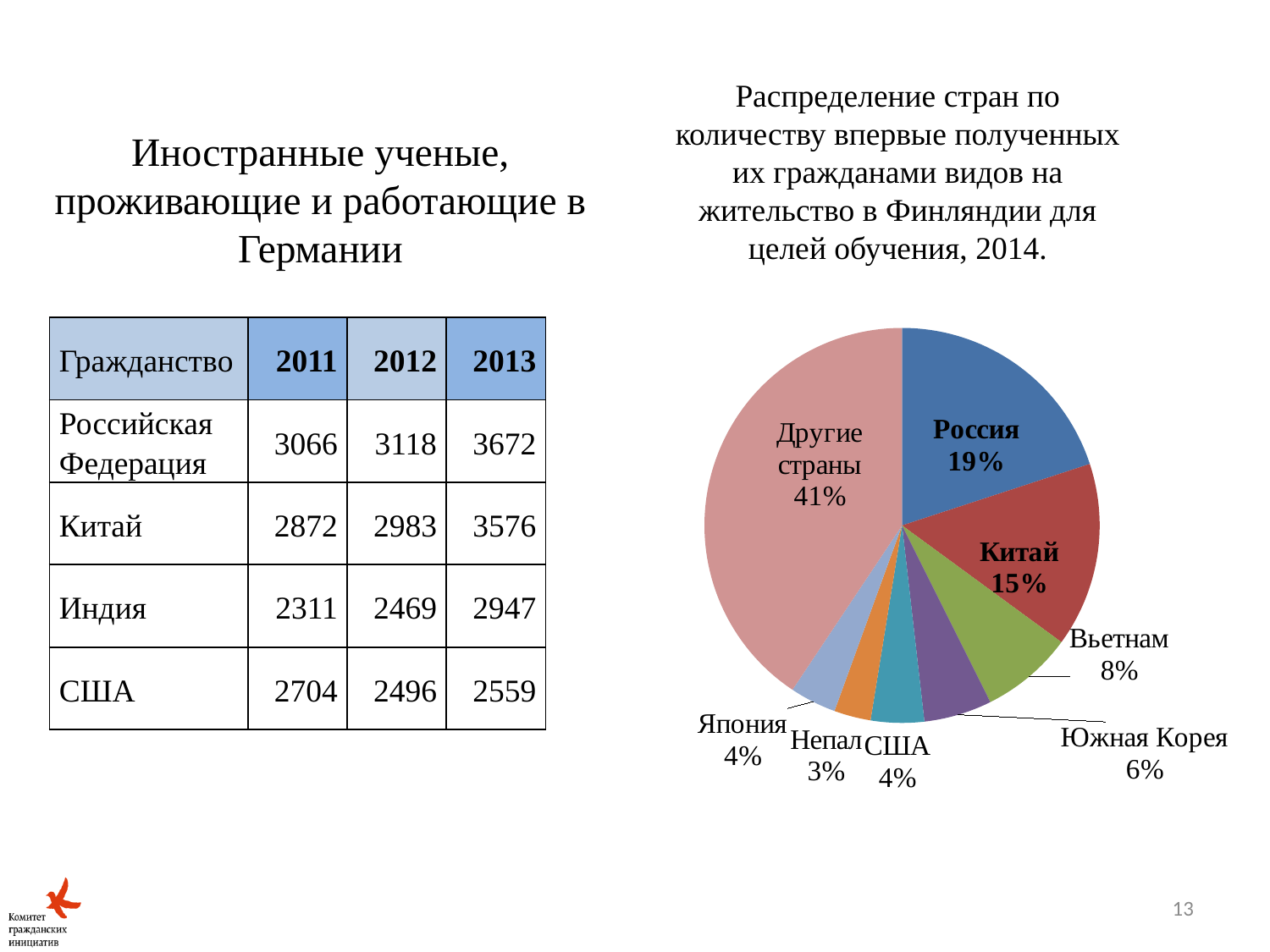
In the pie chart, what share does Китай have? 15% In the pie chart, which slice is the smallest? Непал In the pie chart, what is the combined share of Россия and Китай? 34% In the pie chart, which slice is the largest? Другие страны In the pie chart, what share does Вьетнам have? 8% In the pie chart, which is larger, Вьетнам or Южная Корея? Вьетнам In the pie chart, how many slices are there? 8 In the pie chart, what share does Южная Корея have? 6% In the pie chart, what is the difference in percentage points between Россия and Китай? 4 What kind of chart is shown on the right side of the slide? pie chart